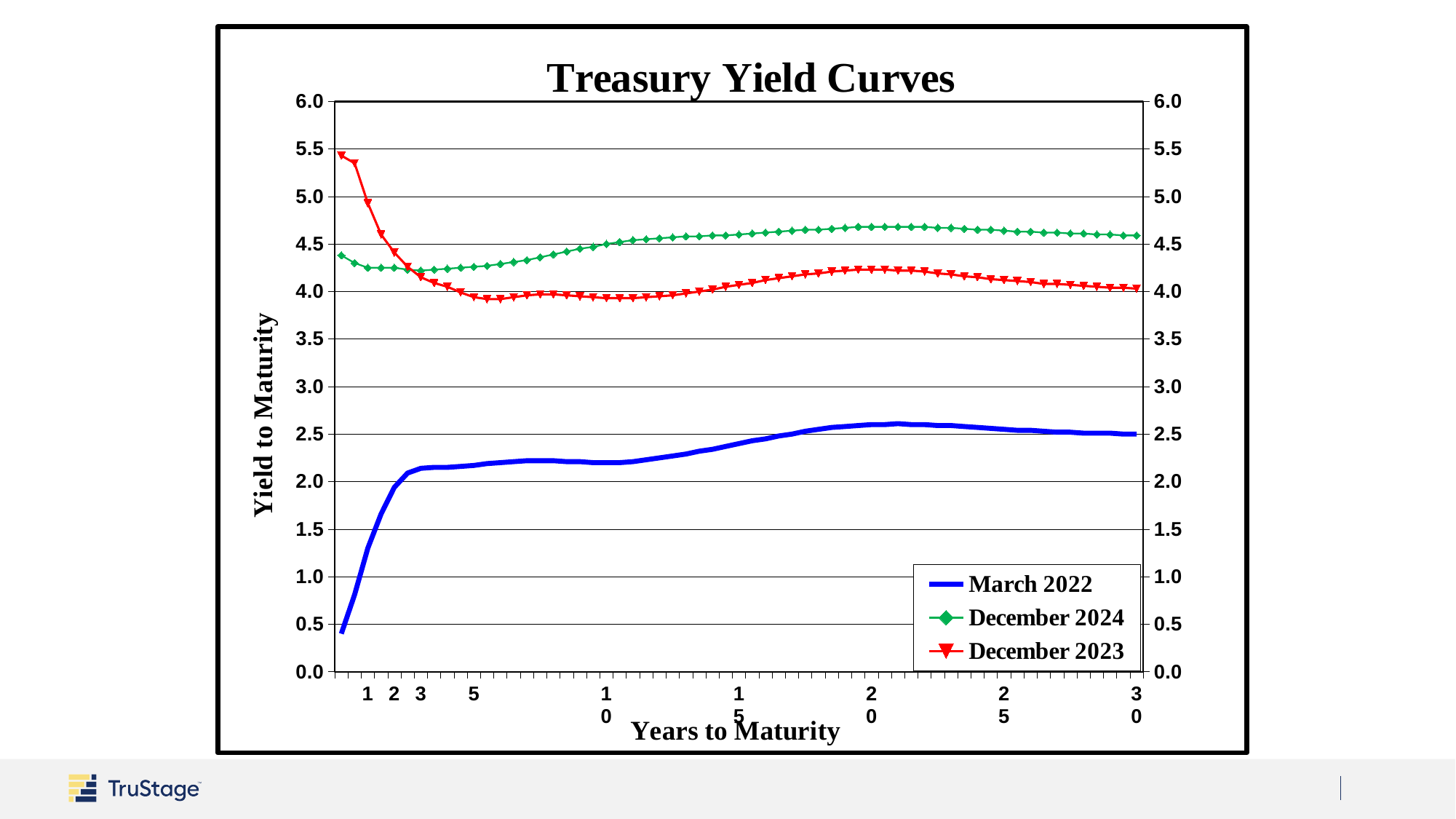
What is the label of the vertical axis? Yield to Maturity What is the title of the chart? Treasury Yield Curves At 1 year to maturity, which series has the higher yield: December 2023 or December 2024? December 2023 At 30 years to maturity, which series has the higher yield: December 2024 or December 2023? December 2024 Is the December 2023 yield at the shortest maturity greater or less than 5.0? greater Does the December 2023 yield rise or fall between 1 and 5 years to maturity? fall Which series has the lowest yields across all maturities? March 2022 How many series does the legend list? 3 Is the December 2024 yield at 30 years to maturity greater or less than 4.5? greater What kind of chart is shown on the slide? line chart Is the March 2022 yield at the shortest maturity greater or less than 1.0? less